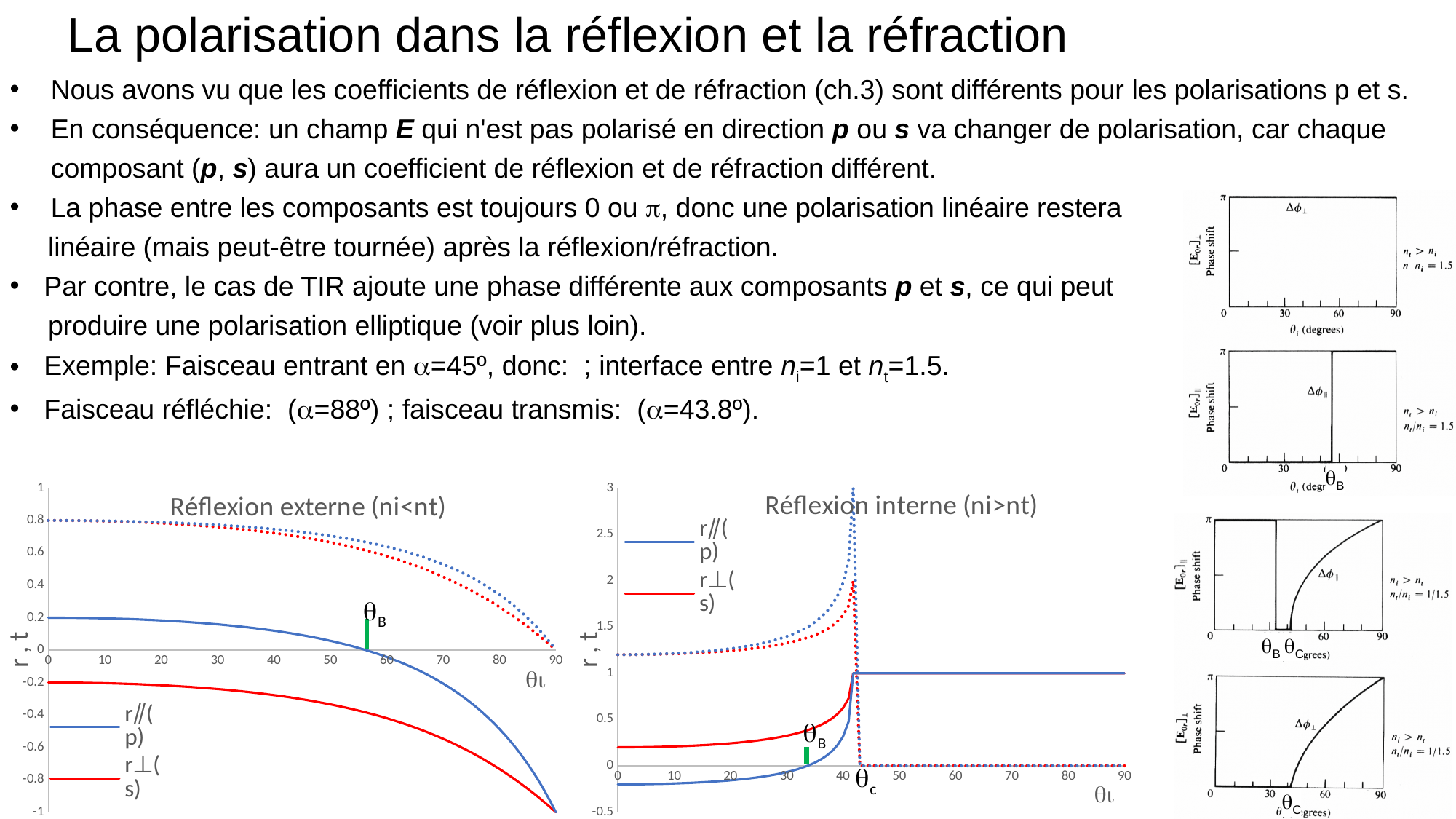
What is the highest value shown on the y axis of the 'Réflexion interne (ni>nt)' chart? 3 In the 'Réflexion externe (ni<nt)' chart, does the solid r//(p) curve rise or fall as θi increases from 0 to 90? fall What kind of chart is the 'Réflexion externe (ni<nt)' chart? line chart In the 'Réflexion interne (ni>nt)' chart, is the solid r//(p) value at θi=0 greater or less than 0? less In the 'Réflexion interne (ni>nt)' chart, is the solid r⊥(s) value at θi=0 greater or less than 0? greater In the 'Réflexion externe (ni<nt)' chart, at θi=40, which solid curve is higher, r//(p) or r⊥(s)? r//(p) In the 'Réflexion externe (ni<nt)' chart, which series is drawn in red? r⊥(s) In the 'Réflexion interne (ni>nt)' chart, do the dotted curves rise or fall as θi increases from 0 toward θc? rise How many series does the legend of the 'Réflexion interne (ni>nt)' chart list? 2 In the 'Réflexion externe (ni<nt)' chart, is the solid r⊥(s) value at θi=70 greater or less than -0.4? less In the 'Réflexion interne (ni>nt)' chart, what constant value do the solid curves take for θi above θc? 1 What is the title of the chart on the left of the slide? Réflexion externe (ni<nt)